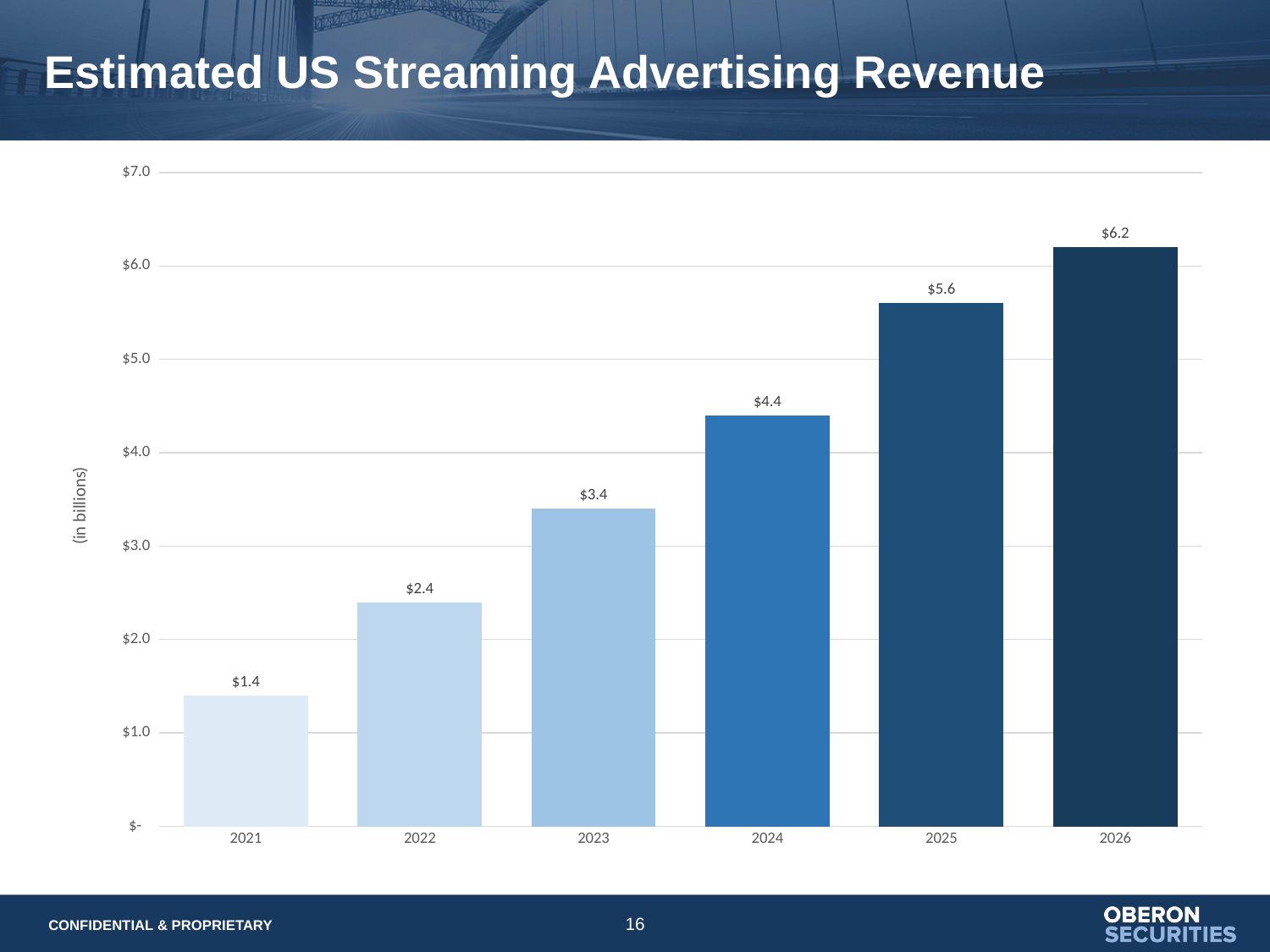
Which year has the highest estimated US streaming advertising revenue? 2026 What is the estimated US streaming advertising revenue for 2024? $4.4 What is the estimated US streaming advertising revenue for 2021? $1.4 What is the difference between the estimated revenue for 2025 and 2023? $2.2 How many years are shown on the chart? 6 What kind of chart is shown on the slide? Bar chart Which year has a larger estimated revenue, 2022 or 2024? 2024 Which year has the lowest estimated US streaming advertising revenue? 2021 What unit is shown on the vertical axis label of the chart? (in billions) Is the value for 2025 greater or less than $5.0? greater What is the estimated US streaming advertising revenue for 2026? $6.2 Do the estimated revenue values rise or fall from 2021 to 2026? Rise